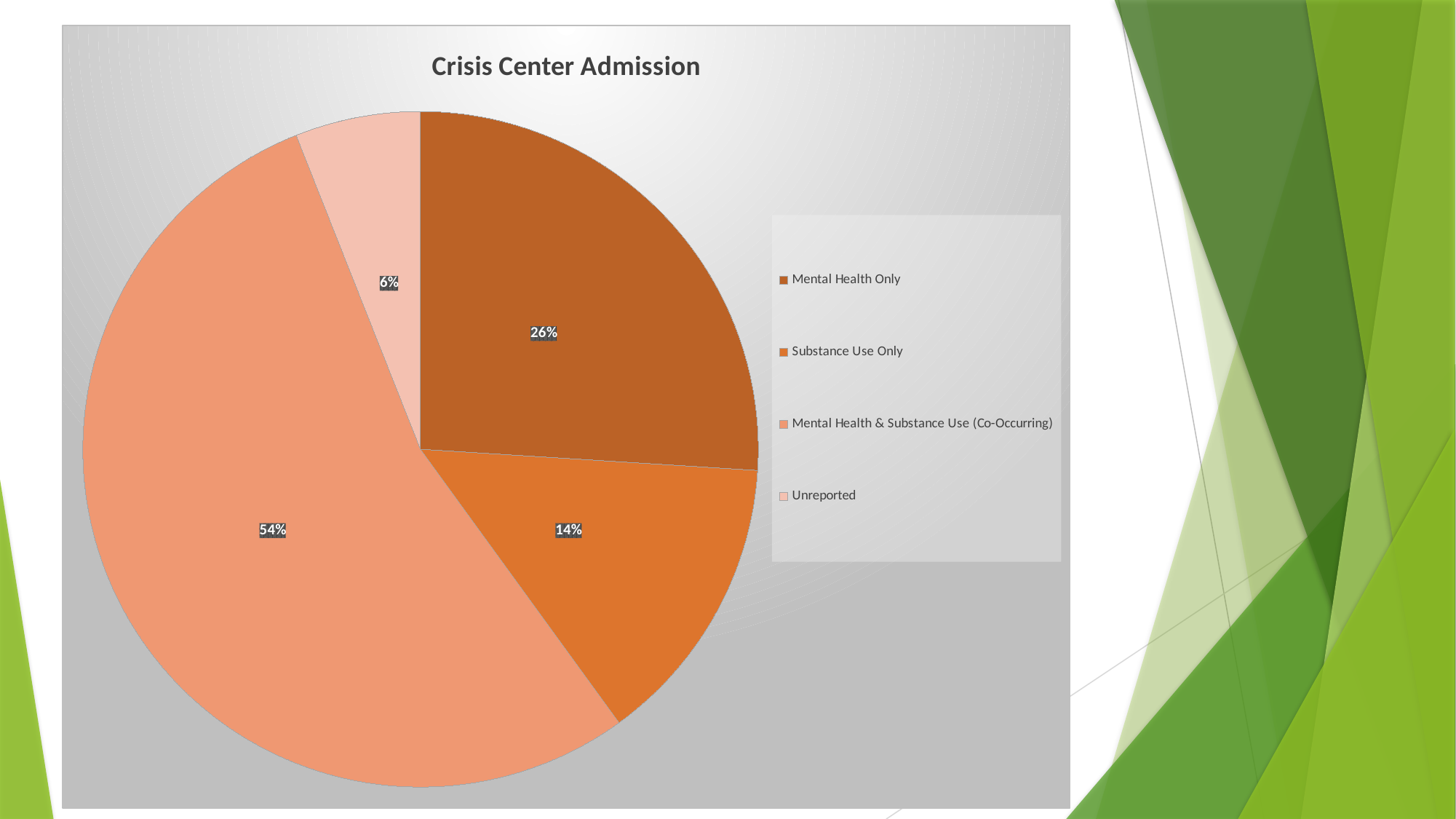
What is the title of the chart? Crisis Center Admission What is the combined share of Mental Health Only and Substance Use Only? 40% How many categories does the legend list? 4 What share of admissions is Mental Health Only? 26% What share of admissions is Substance Use Only? 14% Which category has the largest slice of the pie? Mental Health & Substance Use (Co-Occurring) Which category has the smallest slice of the pie? Unreported What kind of chart is shown on the slide? pie chart Which is larger, Mental Health Only or Substance Use Only? Mental Health Only What share of admissions is Unreported? 6% What share of admissions is Mental Health & Substance Use (Co-Occurring)? 54% What is the difference in percentage points between the Co-Occurring slice and the Mental Health Only slice? 28